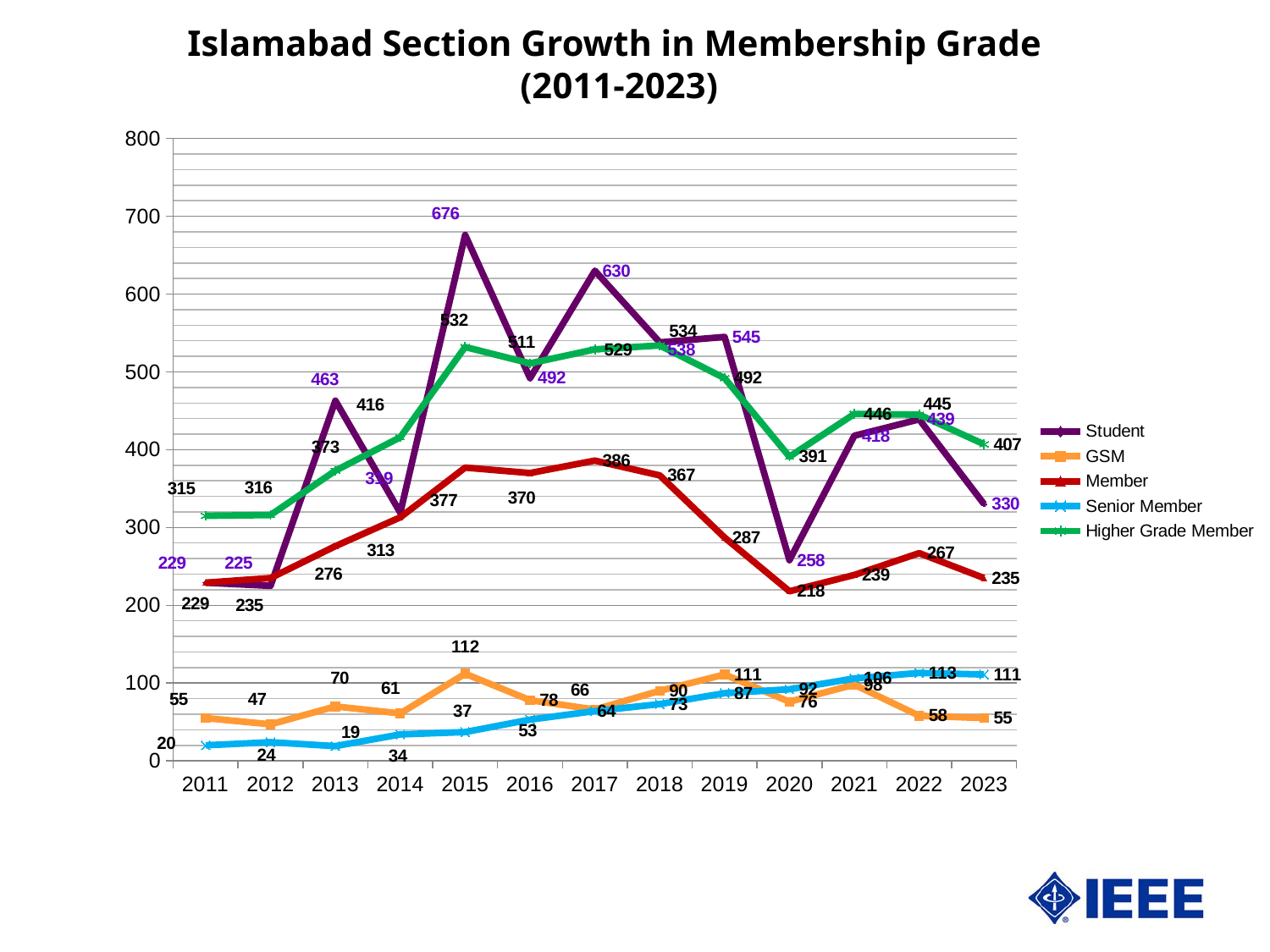
What is the Higher Grade Member value in 2023? 407 Does the Senior Member series generally rise or fall from 2011 to 2022? rise What is the Student value in 2015? 676 In which year is the Senior Member series at its lowest? 2013 What is the GSM value in 2019? 111 What is the difference between the Member value in 2017 and in 2020? 168 What type of chart is shown on the slide? line chart In which year does the Student series reach its highest value? 2015 How many years are plotted along the x axis? 13 Which is larger in 2016, the Student value or the Higher Grade Member value? Higher Grade Member How many series does the legend list? 5 What is the title of the chart? Islamabad Section Growth in Membership Grade (2011-2023)